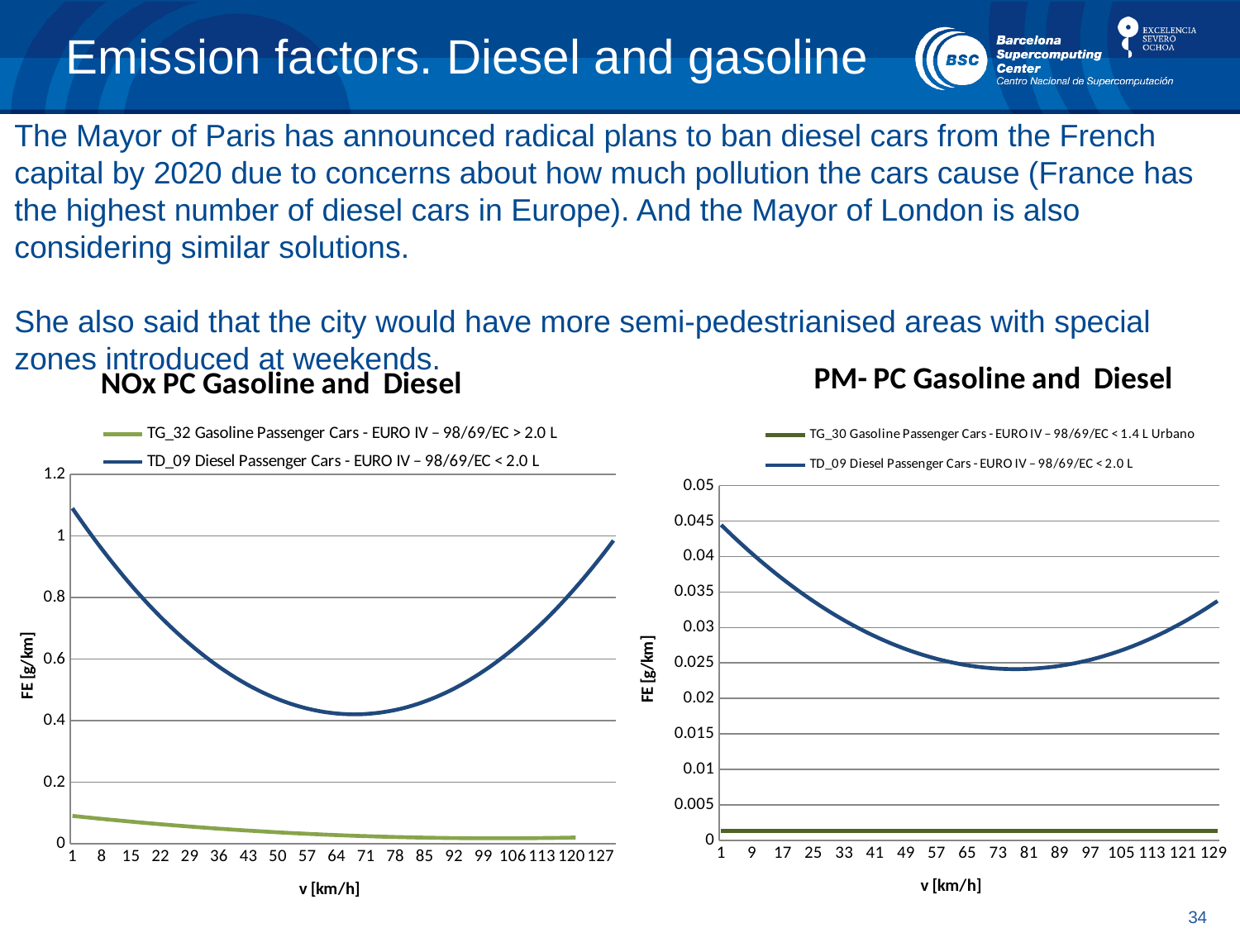
How many series does the legend of the 'PM- PC Gasoline and Diesel' chart list? 2 In the 'PM- PC Gasoline and Diesel' chart, is the value of the TD_09 Diesel series at v = 1 km/h greater or less than 0.04? greater In the 'NOx PC Gasoline and Diesel' chart, which series is drawn in green? TG_32 Gasoline Passenger Cars - EURO IV – 98/69/EC > 2.0 L In the 'NOx PC Gasoline and Diesel' chart, is the value of the TD_09 Diesel series at v = 1 km/h greater or less than 1? greater What kind of chart is the 'NOx PC Gasoline and Diesel' chart? line chart In the 'PM- PC Gasoline and Diesel' chart, is the value of the TG_30 Gasoline series at v = 65 km/h greater or less than 0.005? less What is the y-axis label of the 'PM- PC Gasoline and Diesel' chart? FE [g/km] In the 'NOx PC Gasoline and Diesel' chart, does the TG_32 Gasoline series rise or fall as speed increases along the x axis? fall In the 'NOx PC Gasoline and Diesel' chart, does the TD_09 Diesel series rise or fall between v = 71 km/h and v = 127 km/h? rise In the 'NOx PC Gasoline and Diesel' chart, which series has the higher value at v = 50 km/h, TG_32 Gasoline or TD_09 Diesel? TD_09 Diesel